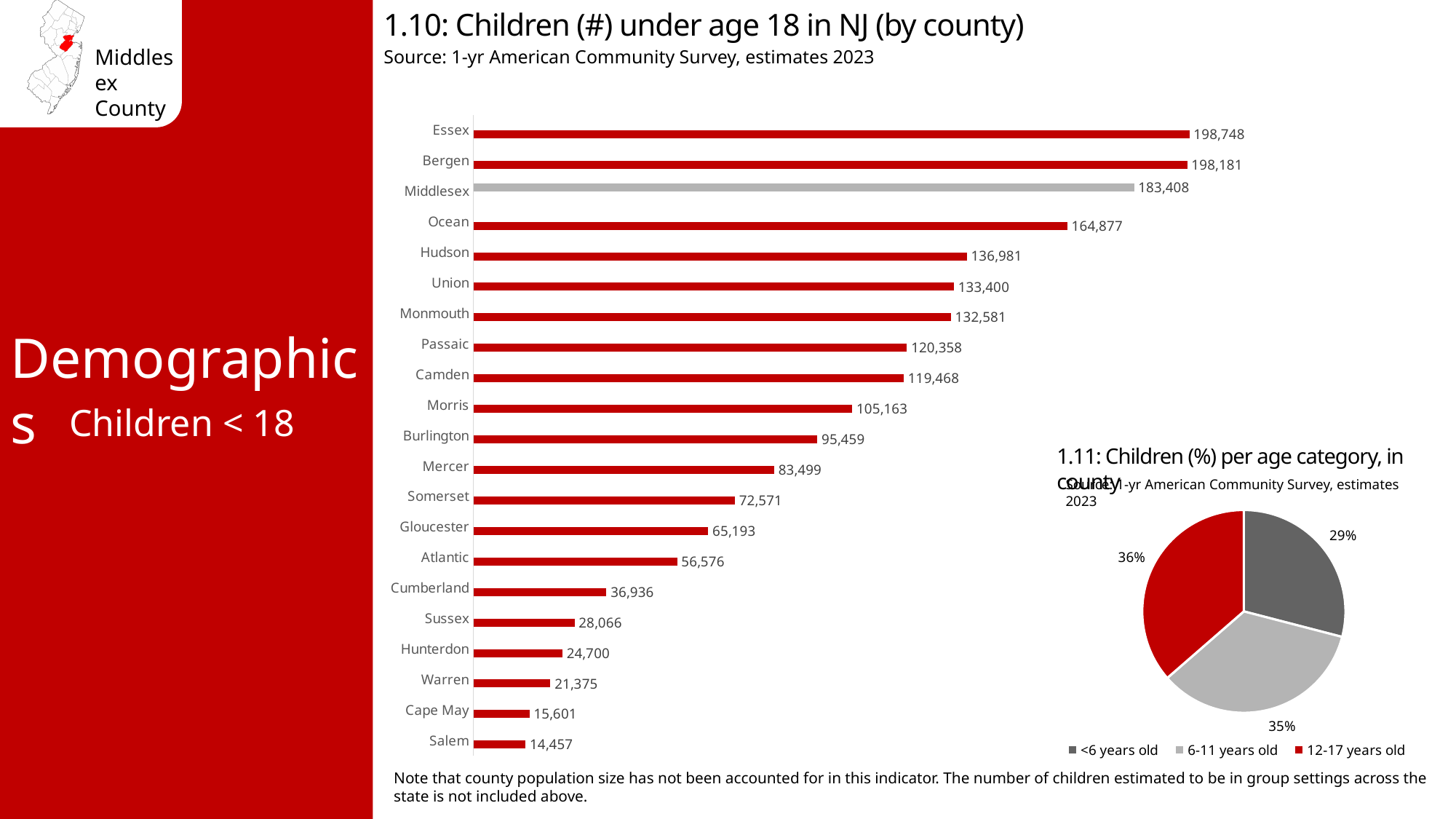
In chart 1.10, how many counties are shown? 21 In chart 1.11, what percentage of children are 6-11 years old? 35% In chart 1.10, which county has the lowest number of children under 18? Salem In chart 1.10, how many children under age 18 are in Middlesex County? 183,408 In chart 1.11, which age category has the smallest share? <6 years old In chart 1.10, which county has the highest number of children under 18? Essex How many categories does the legend of chart 1.11 list? 3 In chart 1.10, what is the difference between the values for Middlesex and Ocean? 18,531 What type of chart is chart 1.10? bar chart In chart 1.10, which has more children under 18, Passaic or Camden? Passaic In chart 1.10, which county's bar is coloured grey instead of red? Middlesex In chart 1.10, what is the value for Hudson? 136,981